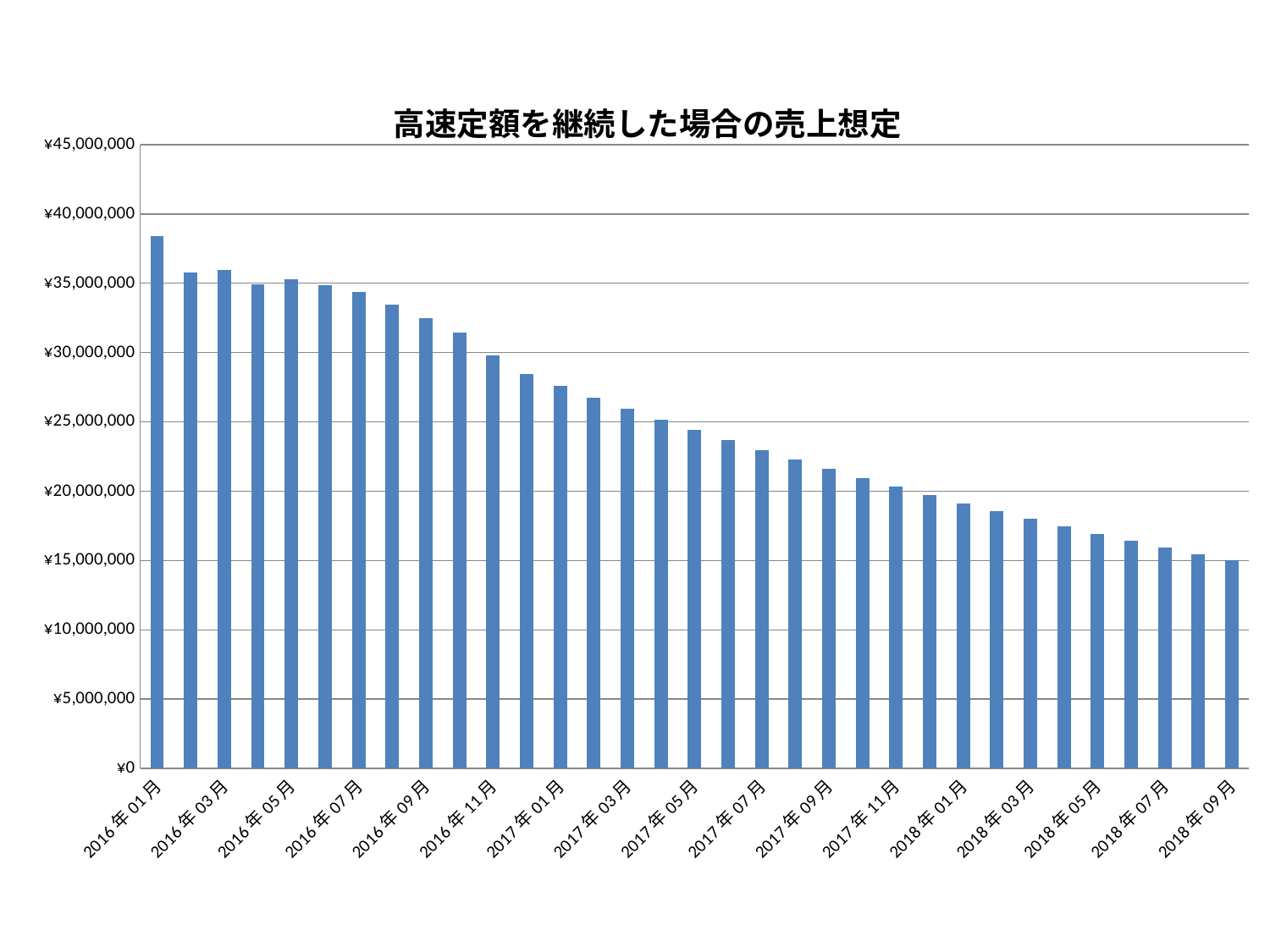
Do the values rise or fall from left to right along the x axis? Fall Is the value for 2016年01月 greater or less than ¥35,000,000? greater What kind of chart is shown on the slide? Bar chart Is the value for 2018年09月 greater or less than ¥20,000,000? less What is the title of the chart? 高速定額を継続した場合の売上想定 How many bars (months) are plotted in the chart? 33 Which is larger, the value for 2016年03月 or the value for 2017年03月? 2016年03月 Which is larger, the value for 2016年01月 or the value for 2016年03月? 2016年01月 Is the value for 2017年01月 greater or less than ¥25,000,000? greater Which month has the lowest value in the chart? 2018年09月 Which month has the highest value in the chart? 2016年01月